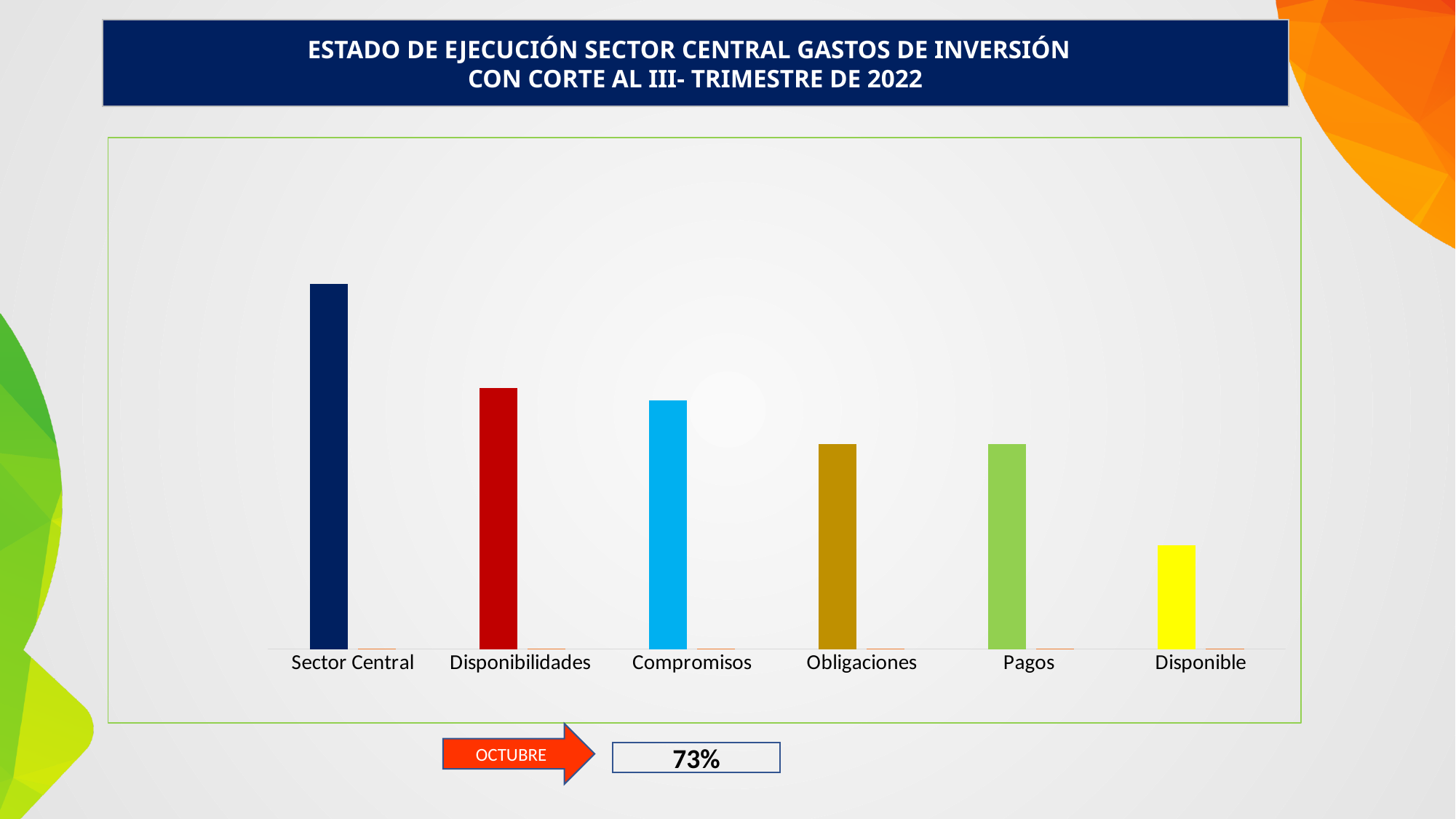
Which bar is taller, Sector Central or Disponibilidades? Sector Central What kind of chart is shown on the slide? bar chart What colour is the bar for Disponible? yellow What is the title shown above the chart? ESTADO DE EJECUCIÓN SECTOR CENTRAL GASTOS DE INVERSIÓN CON CORTE AL III- TRIMESTRE DE 2022 Which bar is taller, Disponibilidades or Compromisos? Disponibilidades Which bar is taller, Compromisos or Obligaciones? Compromisos Which category has the shortest bar in the chart? Disponible How many categories are shown on the x axis of the chart? 6 Which category has the tallest bar in the chart? Sector Central Do the bar heights generally rise or fall from left to right across the chart? fall